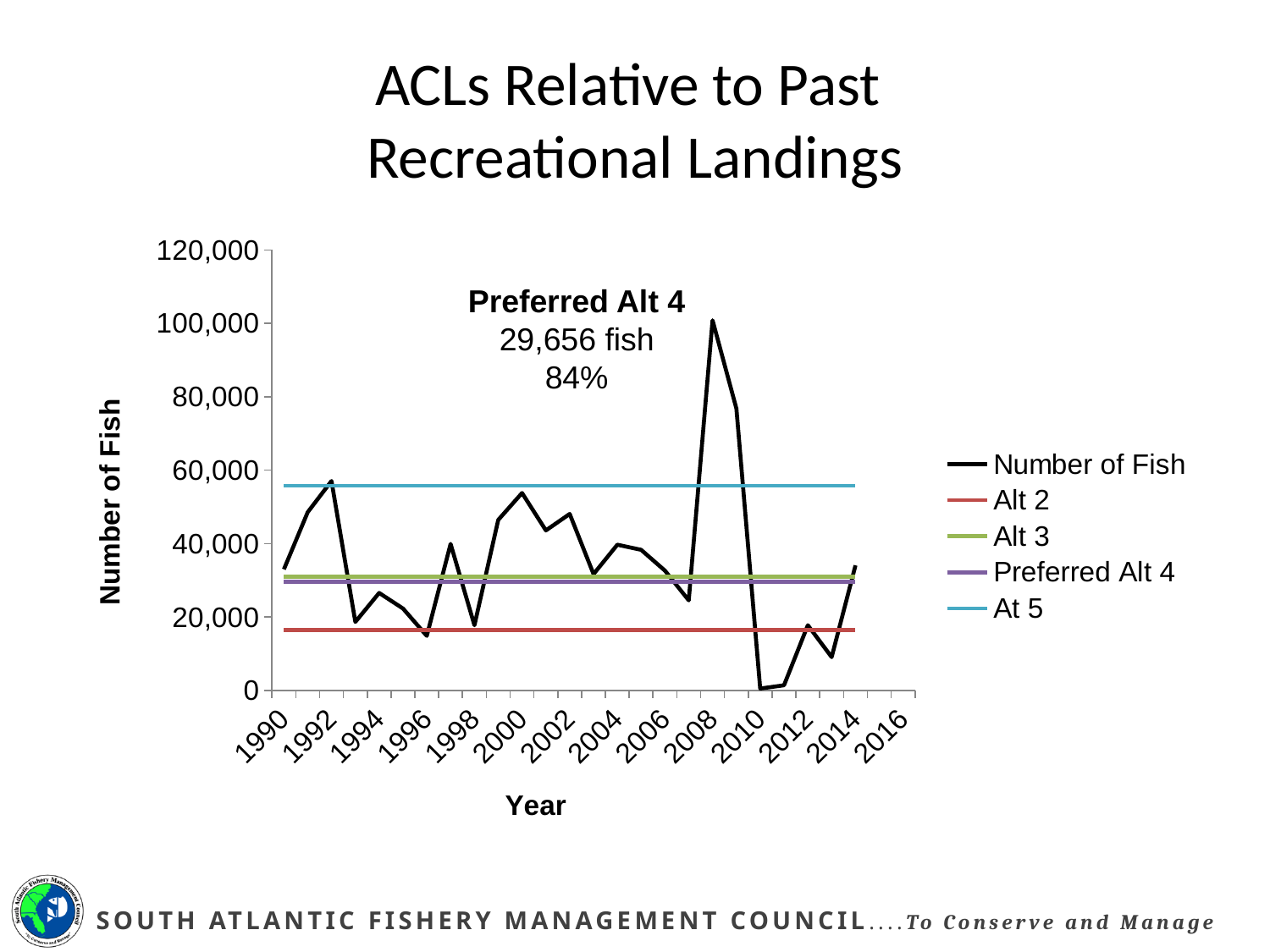
What is the value of the Preferred Alt 4 ACL, as printed on the chart? 29,656 fish How many series does the legend list? 5 What percentage is printed beneath the Preferred Alt 4 annotation? 84% Is the Alt 2 line greater or less than 20,000? less Is the Number of Fish value for 2010 greater or less than 20,000? less Is the At 5 line greater or less than 40,000? greater What is the title of the vertical axis? Number of Fish Does the Number of Fish series rise or fall between 2009 and 2010? fall What kind of chart is shown on the slide? line chart In which year does the Number of Fish series reach its highest value? 2008 Which year has the larger Number of Fish value, 1992 or 1996? 1992